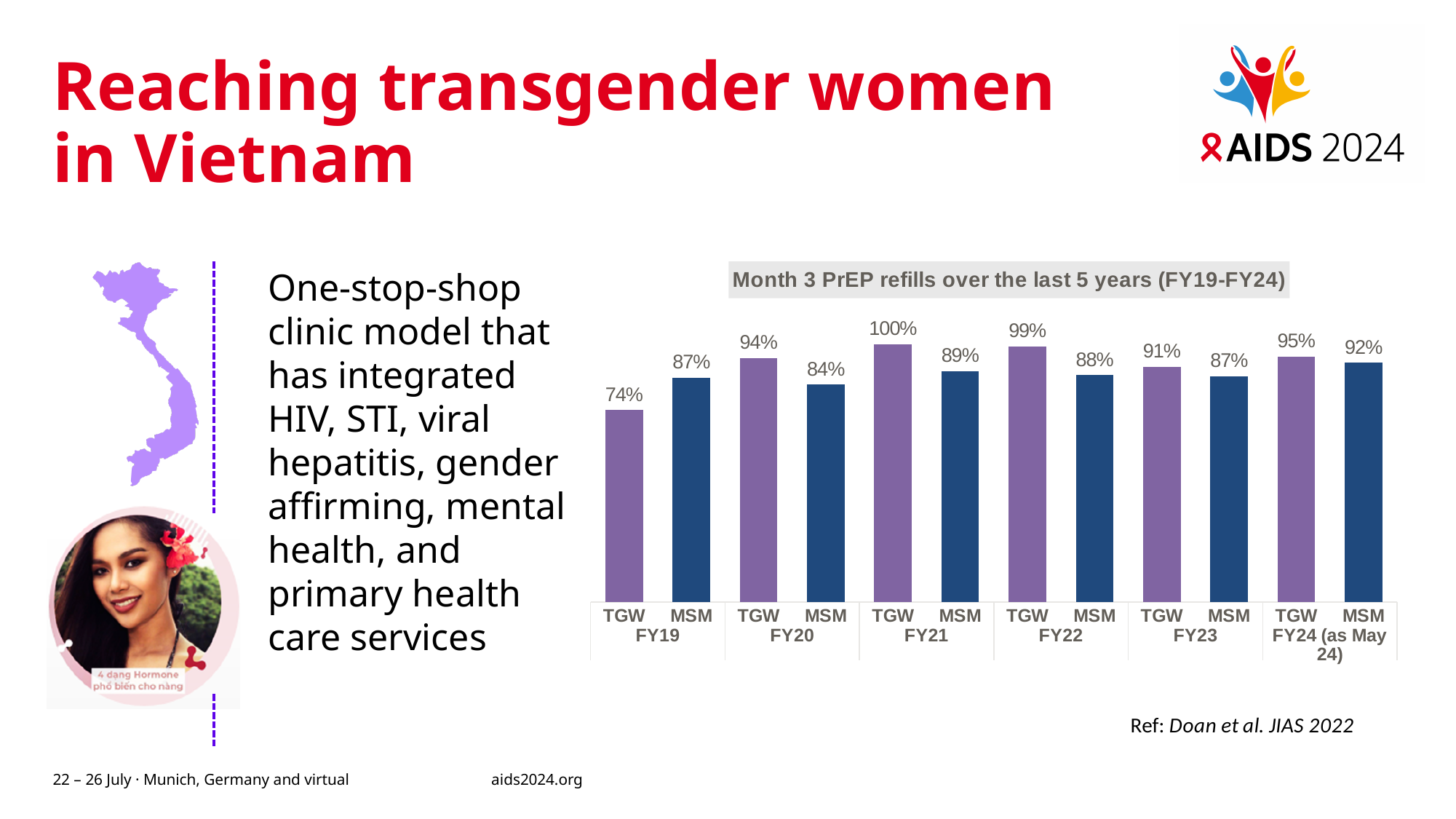
What kind of chart is shown on the slide? Bar chart What is the title of the chart? Month 3 PrEP refills over the last 5 years (FY19-FY24) What is the difference between the TGW value in FY19 and the TGW value in FY20? 20% What is the Month 3 PrEP refill value for TGW in FY19? 74% In FY23, which group has the higher value, TGW or MSM? TGW Which bar has the highest value in the chart? TGW FY21 Which bar has the lowest value in the chart? TGW FY19 In FY19, which group has the higher value, TGW or MSM? MSM How many bars are plotted in the chart? 12 What is the difference between the TGW and MSM values in FY22? 11% What is the Month 3 PrEP refill value for MSM in FY21? 89% What is the Month 3 PrEP refill value for TGW in FY24 (as May 24)? 95%